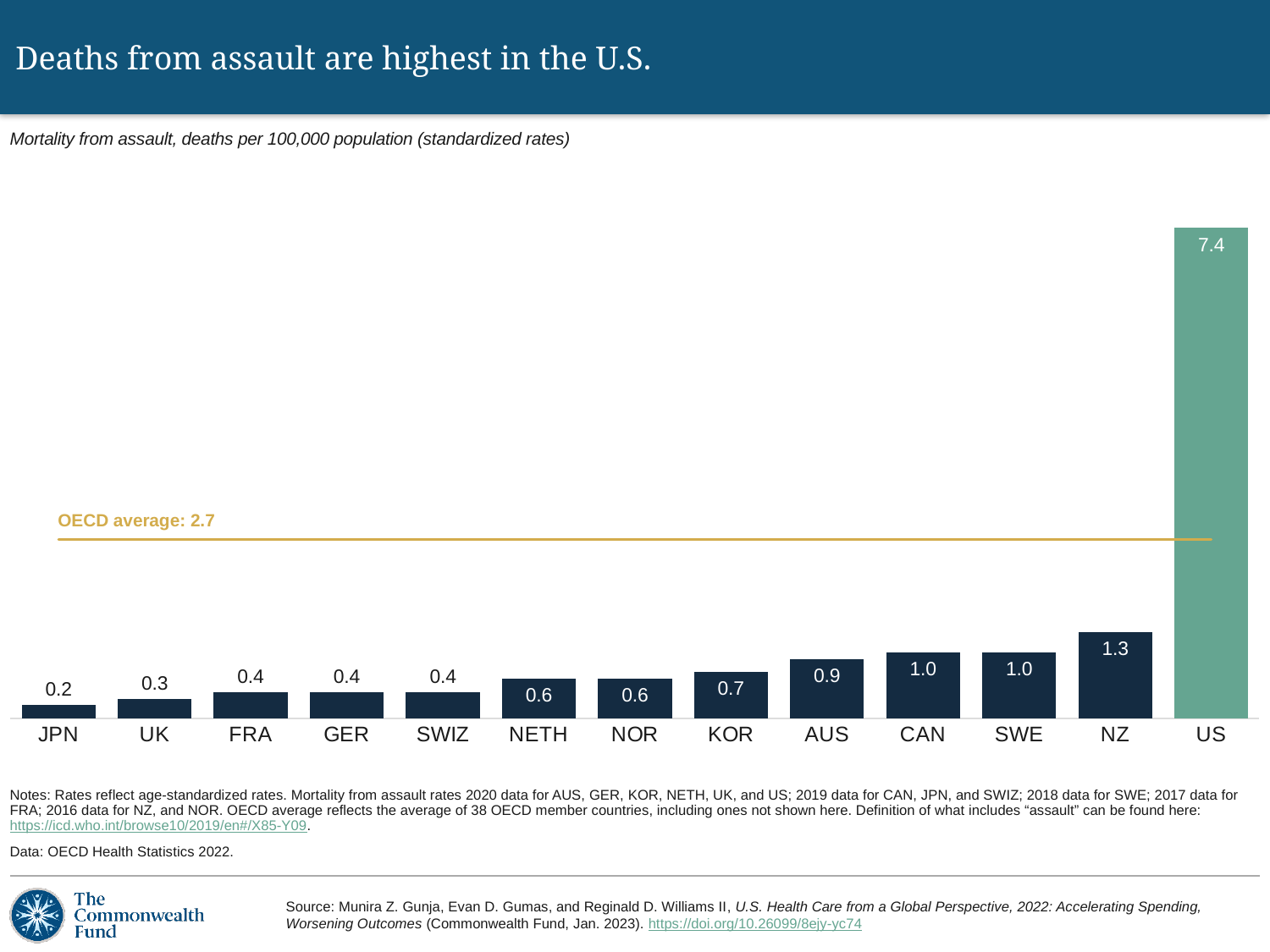
How many countries are shown in the chart? 13 Do the values rise or fall moving from left to right across the chart? Rise What is the mortality from assault rate for JPN? 0.2 What is the mortality from assault rate for the US? 7.4 What is the OECD average shown on the chart? 2.7 What is the difference between the US and NZ mortality from assault rates? 6.1 What is the difference between the mortality from assault rates for CAN and UK? 0.7 Which has a higher mortality from assault rate, KOR or AUS? AUS What is the mortality from assault rate for NZ? 1.3 What kind of chart is shown on the slide? Bar chart Which country has the highest mortality from assault rate? US Which country has the lowest mortality from assault rate? JPN